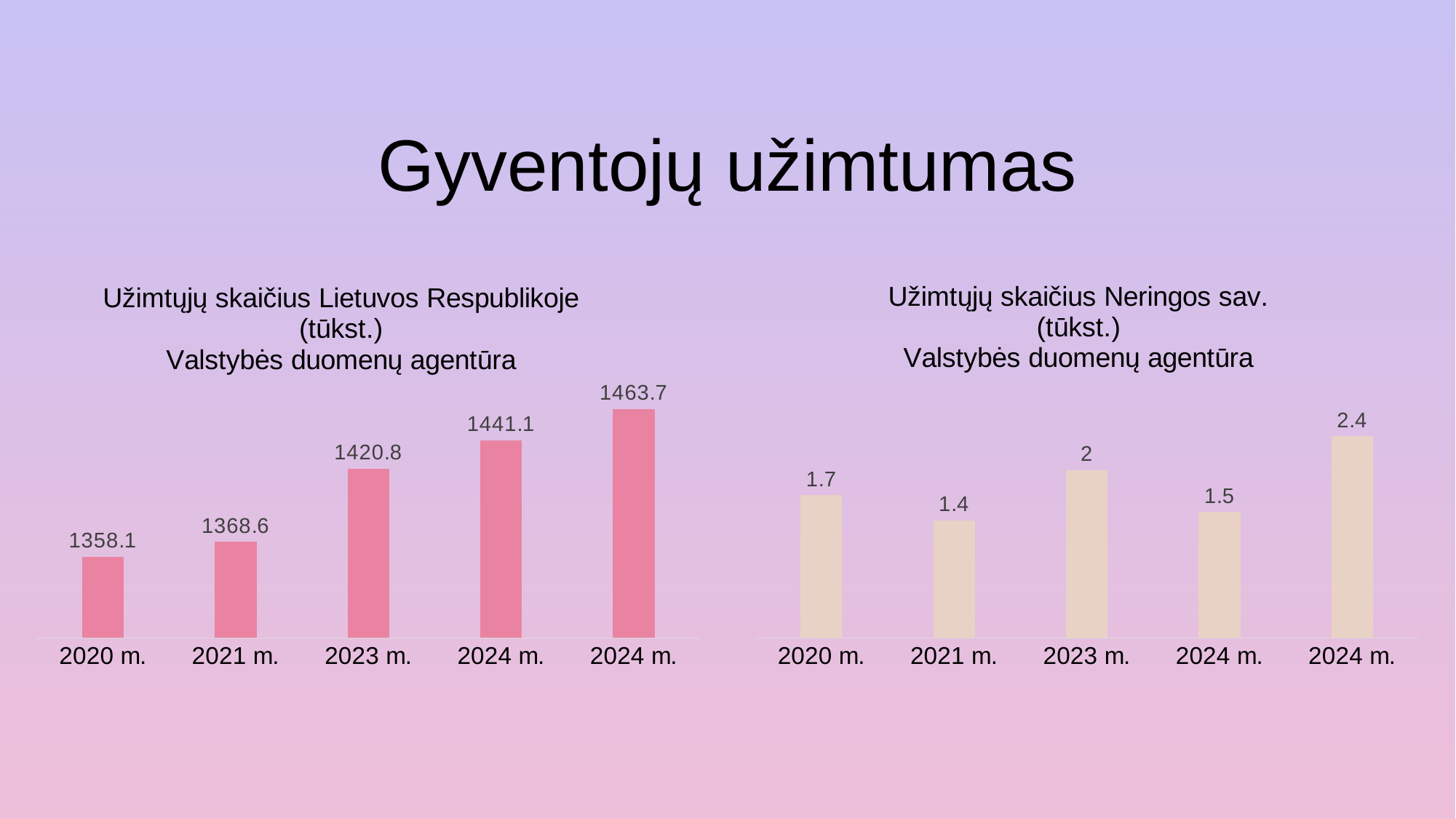
In the chart titled "Užimtųjų skaičius Neringos sav. (tūkst.)", what is the highest value shown? 2.4 In the chart titled "Užimtųjų skaičius Lietuvos Respublikoje (tūkst.)", do the values rise or fall from left to right? rise In the chart titled "Užimtųjų skaičius Lietuvos Respublikoje (tūkst.)", which category has the lowest value? 2020 m. In the chart titled "Užimtųjų skaičius Neringos sav. (tūkst.)", what is the value for 2021 m.? 1.4 In the chart titled "Užimtųjų skaičius Lietuvos Respublikoje (tūkst.)", what is the highest value shown? 1463.7 In the chart titled "Užimtųjų skaičius Neringos sav. (tūkst.)", which is larger, the value for 2020 m. or the value for 2021 m.? 2020 m. In the chart titled "Užimtųjų skaičius Lietuvos Respublikoje (tūkst.)", what is the value for 2023 m.? 1420.8 In the chart titled "Užimtųjų skaičius Neringos sav. (tūkst.)", which category has the lowest value? 2021 m. In the chart titled "Užimtųjų skaičius Neringos sav. (tūkst.)", what is the value for 2023 m.? 2 In the chart titled "Užimtųjų skaičius Lietuvos Respublikoje (tūkst.)", what is the difference between the values for 2021 m. and 2020 m.? 10.5 How many bars does the chart titled "Užimtųjų skaičius Neringos sav. (tūkst.)" have? 5 In the chart titled "Užimtųjų skaičius Lietuvos Respublikoje (tūkst.)", what is the value for 2020 m.? 1358.1